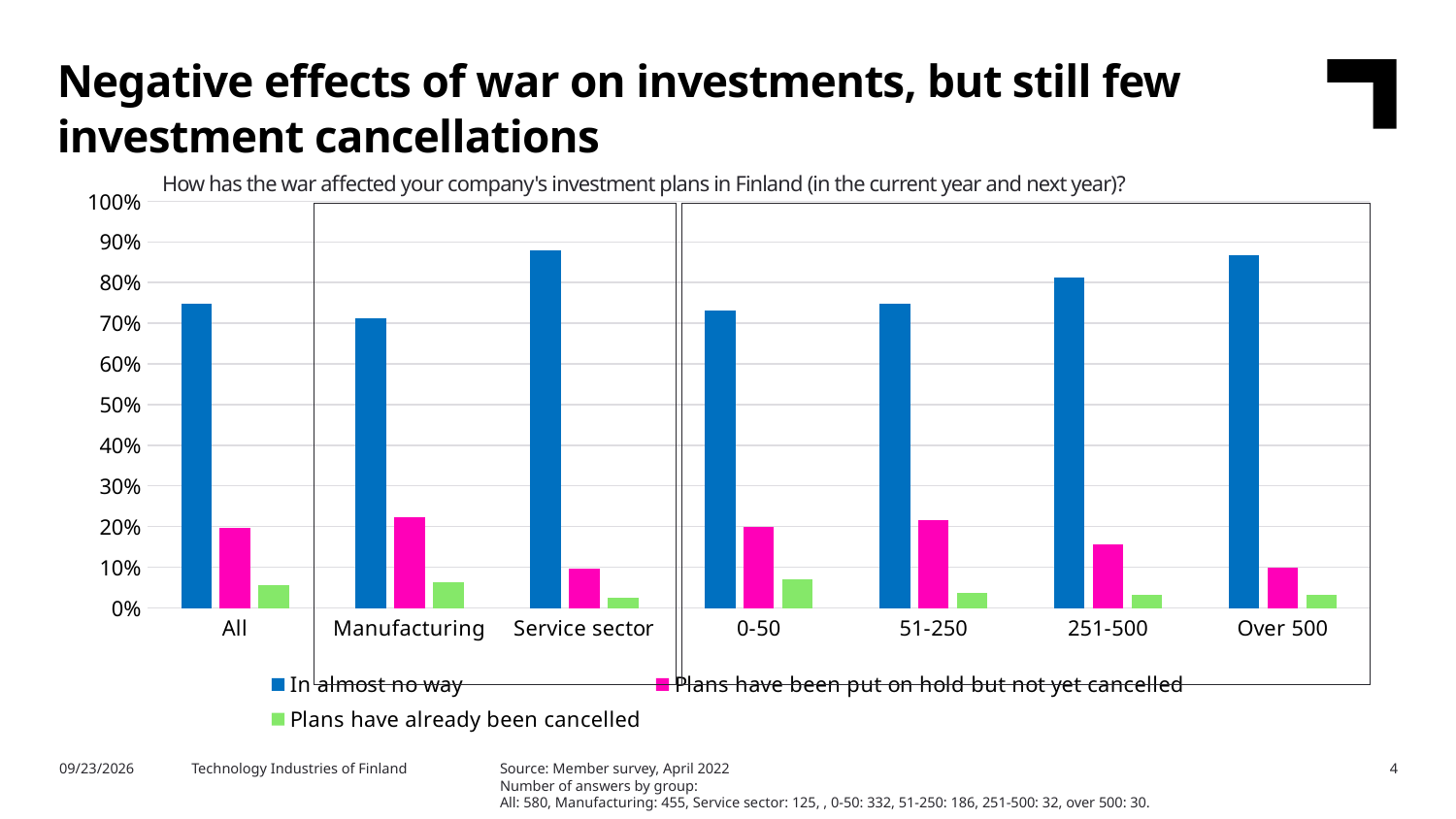
Is the value for 'In almost no way' for companies with Over 500 employees greater or less than 80%? greater How many categories are shown along the x axis of the chart? 7 Is the value for 'Plans have already been cancelled' for All greater or less than 10%? less Which has a higher value for 'In almost no way': 0-50 or Over 500? Over 500 Is the value for 'Plans have been put on hold but not yet cancelled' in the Service sector greater or less than 20%? less How many series does the chart's legend list? 3 Which has a higher value for 'In almost no way': Manufacturing or Service sector? Service sector Which series is shown in green in the chart's legend? Plans have already been cancelled What kind of chart is shown on the slide? bar chart Which has a higher value for 'Plans have been put on hold but not yet cancelled': 51-250 or 251-500? 51-250